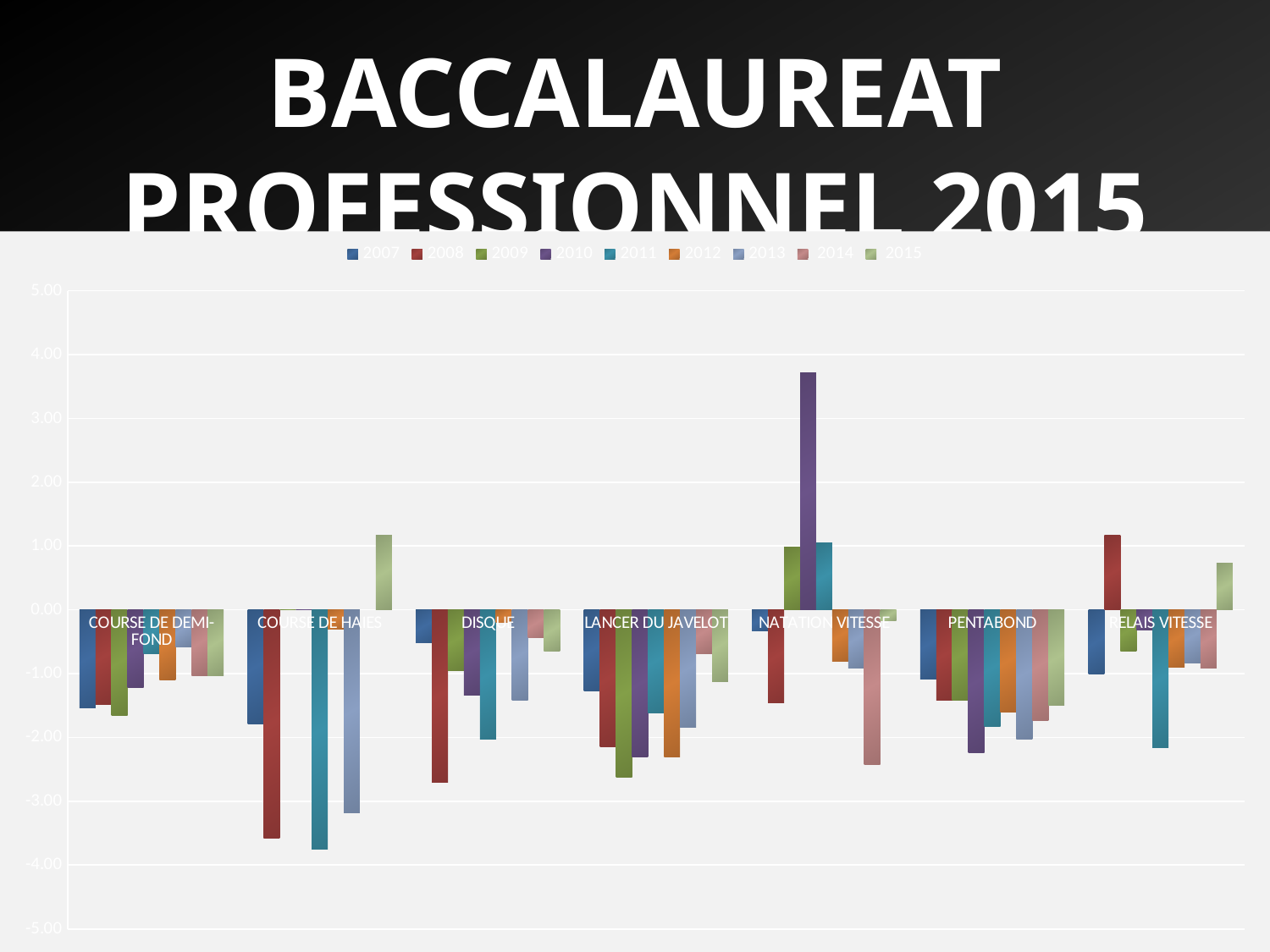
Which category contains the tallest positive bar on the chart? NATATION VITESSE Is the value for 2015 in COURSE DE HAIES greater or less than 0.00? greater Is the value for 2008 in COURSE DE HAIES greater or less than -3.00? less How many categories are shown along the x axis of the chart? 7 How many series does the chart legend list? 9 Which year is listed first in the chart legend? 2007 In the NATATION VITESSE category, which is larger: the value for 2010 or the value for 2011? 2010 Which series has the highest value in the NATATION VITESSE category? 2010 Is the value for 2008 in DISQUE greater or less than -2.00? less What kind of chart is shown on the slide? bar chart